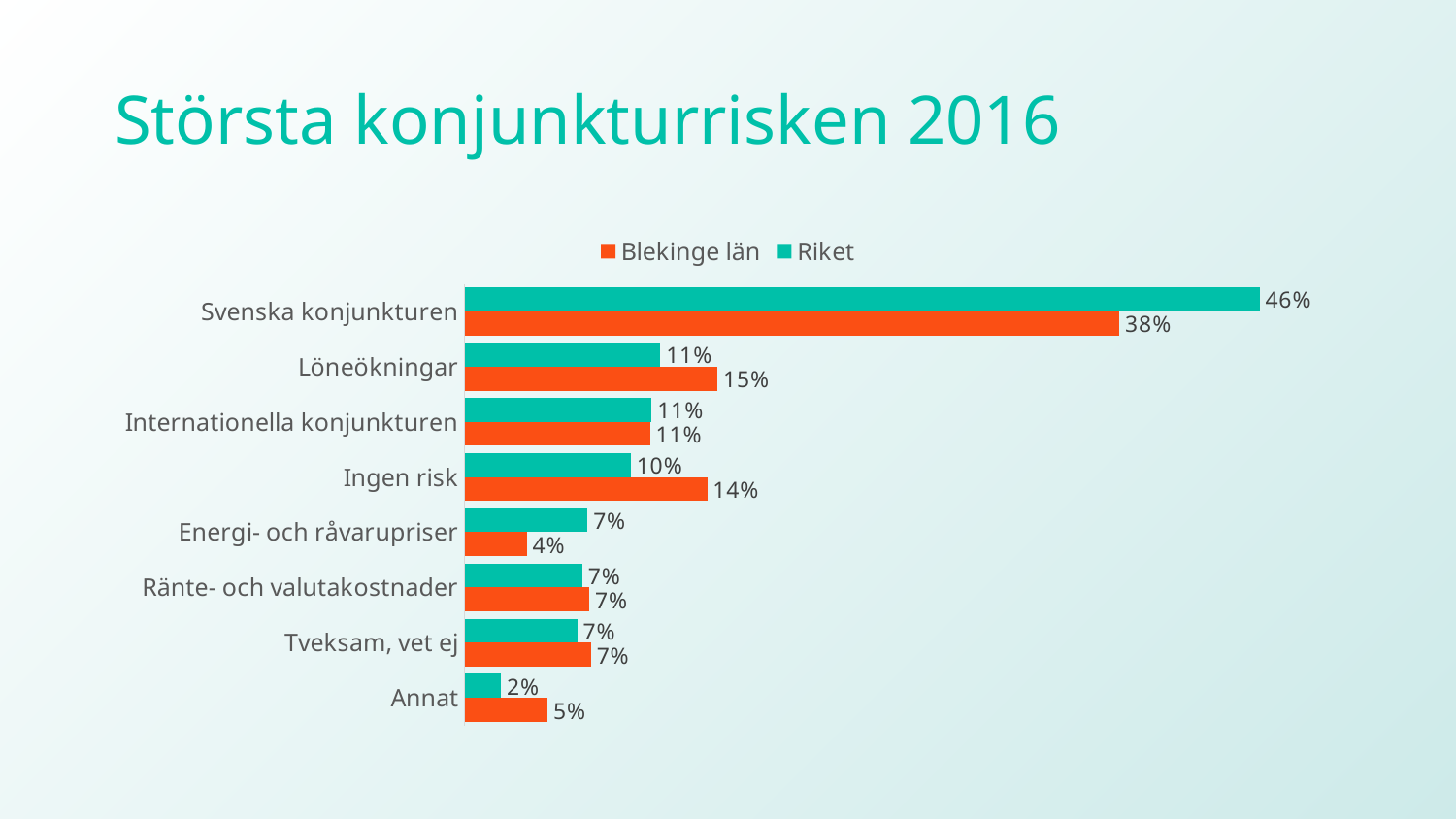
Which category has the highest Blekinge län value? Svenska konjunkturen What is the difference between the Riket and Blekinge län values for Svenska konjunkturen? 8% Which is larger for Energi- och råvarupriser, the Blekinge län value or the Riket value? Riket What is the Riket value for Svenska konjunkturen? 46% What is the title of the slide? Största konjunkturrisken 2016 What kind of chart is shown on the slide? Bar chart How many categories are shown in the chart? 8 What is the Riket value for Annat? 2% How many series does the legend list? 2 What is the Blekinge län value for Löneökningar? 15% What is the Blekinge län value for Ingen risk? 14% Which category has the lowest Riket value? Annat